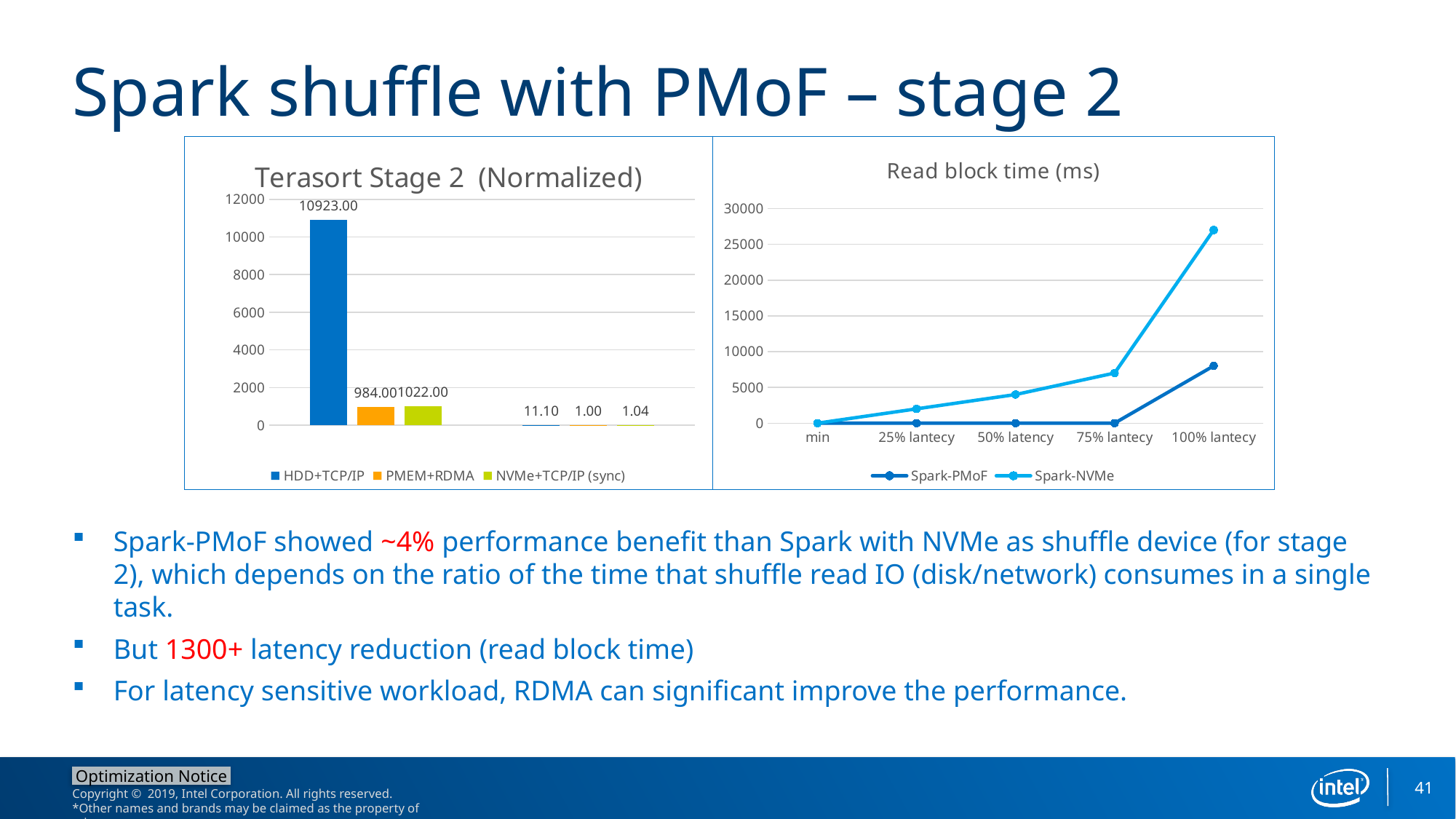
In the "Terasort Stage 2 (Normalized)" chart, what is the difference between the HDD+TCP/IP value (10923.00) and the PMEM+RDMA value (984.00) in the first group of bars? 9939.00 In the "Terasort Stage 2 (Normalized)" chart, how many series does the legend list? 3 In the "Read block time (ms)" chart, how many categories are on the x axis? 5 In the "Terasort Stage 2 (Normalized)" chart, which series has the highest value in the first group of bars? HDD+TCP/IP In the "Terasort Stage 2 (Normalized)" chart, what is the value labeled on the PMEM+RDMA bar in the first group of bars? 984.00 In the "Terasort Stage 2 (Normalized)" chart, what is the value labeled on the NVMe+TCP/IP (sync) bar in the first group of bars? 1022.00 In the "Terasort Stage 2 (Normalized)" chart, what is the value labeled on the tallest HDD+TCP/IP bar? 10923.00 What type of chart is the "Terasort Stage 2 (Normalized)" chart on the left? bar chart In the "Read block time (ms)" chart, is the Spark-NVMe value at 100% lantecy greater or less than 25000? greater What type of chart is the "Read block time (ms)" chart on the right? line chart In the "Read block time (ms)" chart, which series has the larger value at 100% lantecy, Spark-PMoF or Spark-NVMe? Spark-NVMe In the "Read block time (ms)" chart, how many series does the legend list? 2